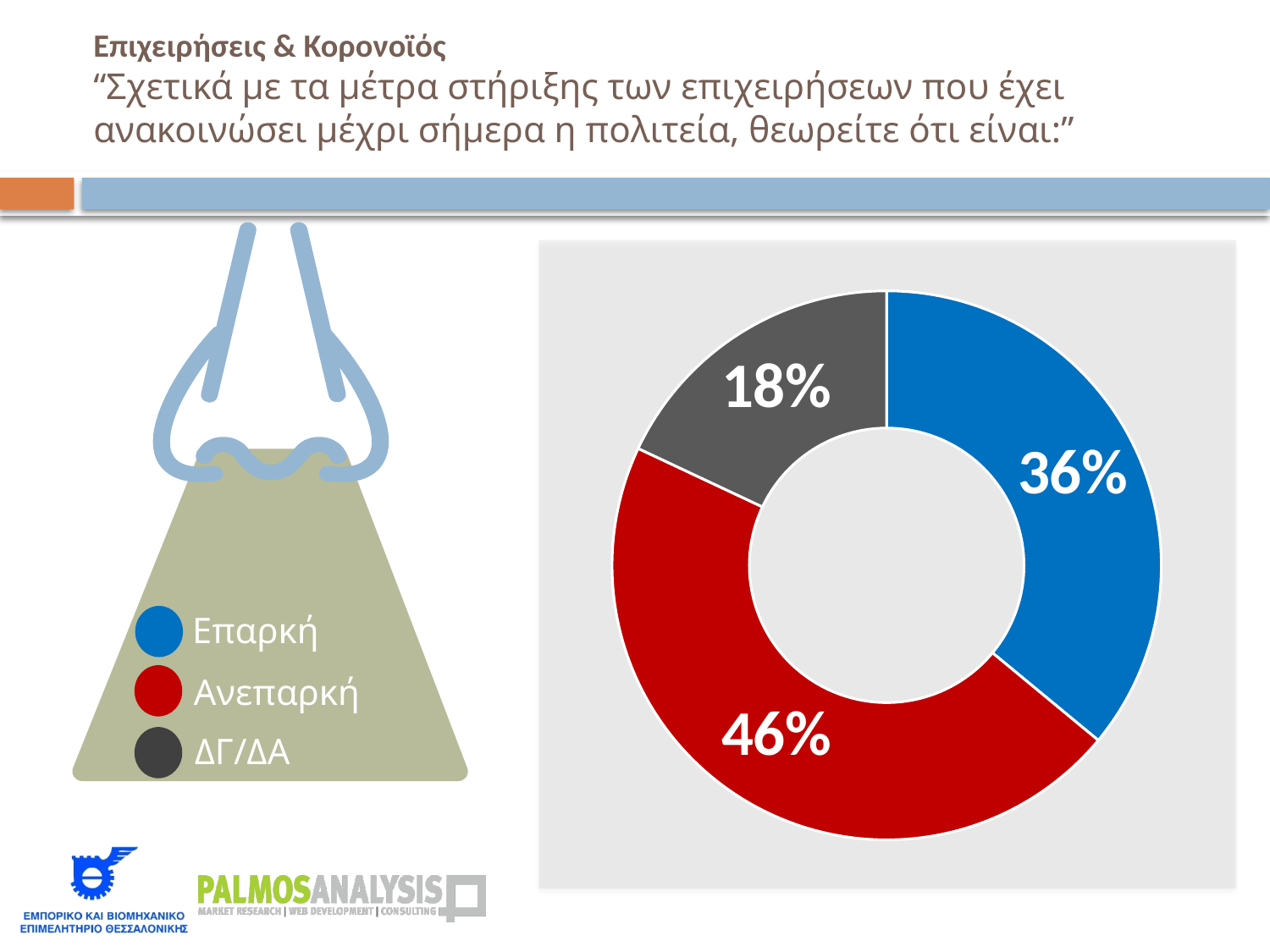
What percentage of respondents answered Ανεπαρκή? 46% Which response has the smallest share of the chart? ΔΓ/ΔΑ What percentage of respondents answered Επαρκή? 36% How many categories does the chart show? 3 What is the difference in percentage points between Επαρκή and ΔΓ/ΔΑ? 18 Which response has the largest share of the chart? Ανεπαρκή What kind of chart is shown on the slide? Doughnut (pie) chart What colour represents Ανεπαρκή in the chart? Red What is the difference in percentage points between Ανεπαρκή and Επαρκή? 10 What colour represents ΔΓ/ΔΑ in the chart? Dark grey What percentage of respondents answered ΔΓ/ΔΑ? 18% Which is larger, the share for Επαρκή or the share for Ανεπαρκή? Ανεπαρκή